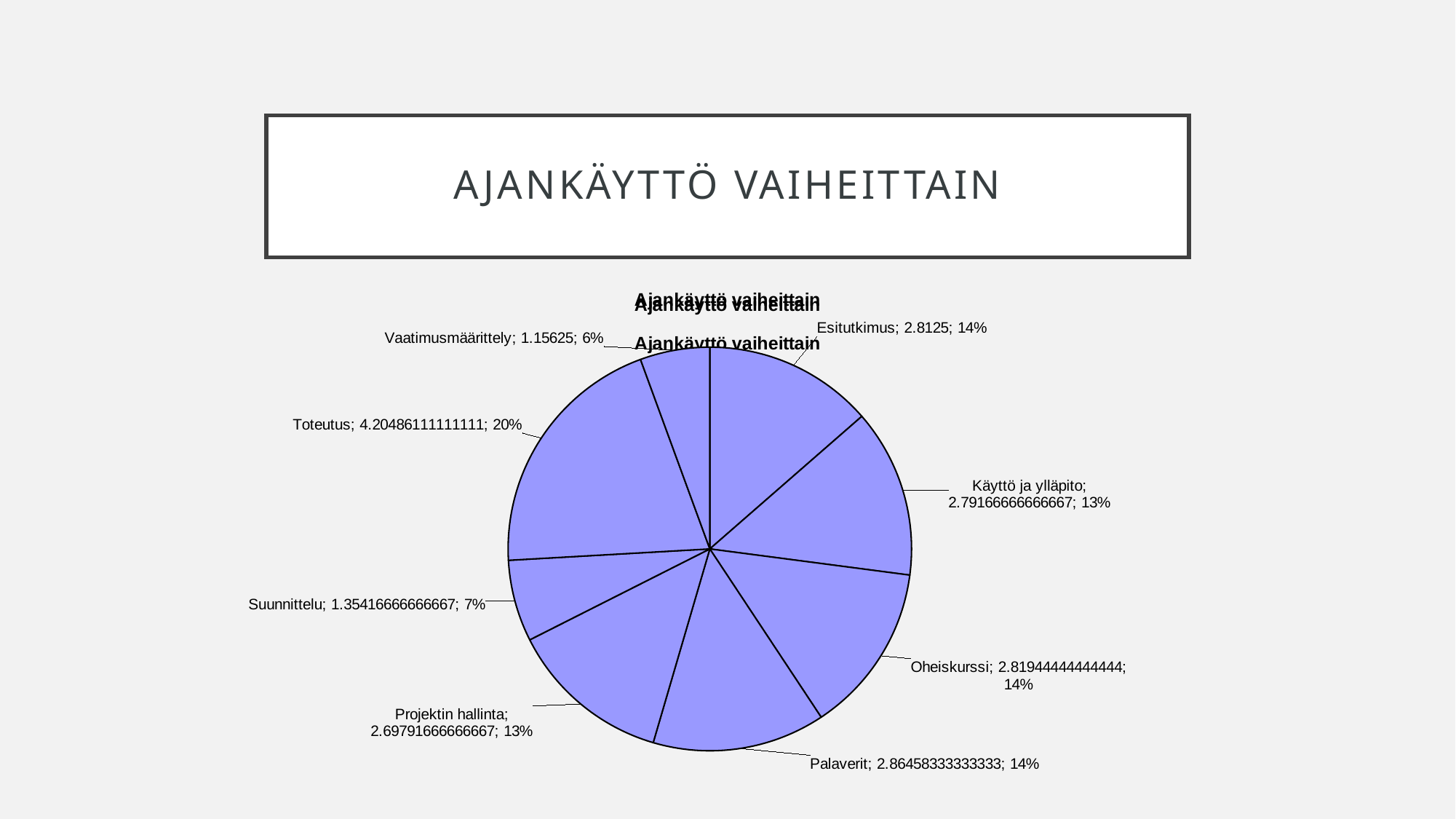
What is the difference in percentage share between Toteutus and Vaatimusmäärittely? 14 percentage points Which category has the smallest slice of the pie? Vaatimusmäärittely What share of the pie does Suunnittelu represent? 7% What is the value for Vaatimusmäärittely? 1.15625 What is the value for Esitutkimus? 2.8125 Which category has the largest slice of the pie? Toteutus Which is larger, the value for Toteutus or the value for Suunnittelu? Toteutus What is the title of the chart? Ajankäyttö vaiheittain What is the value for Toteutus? 4.20486111111111 What kind of chart is shown on the slide? pie chart What share of the pie does Toteutus represent? 20% How many slices does the pie chart have? 8